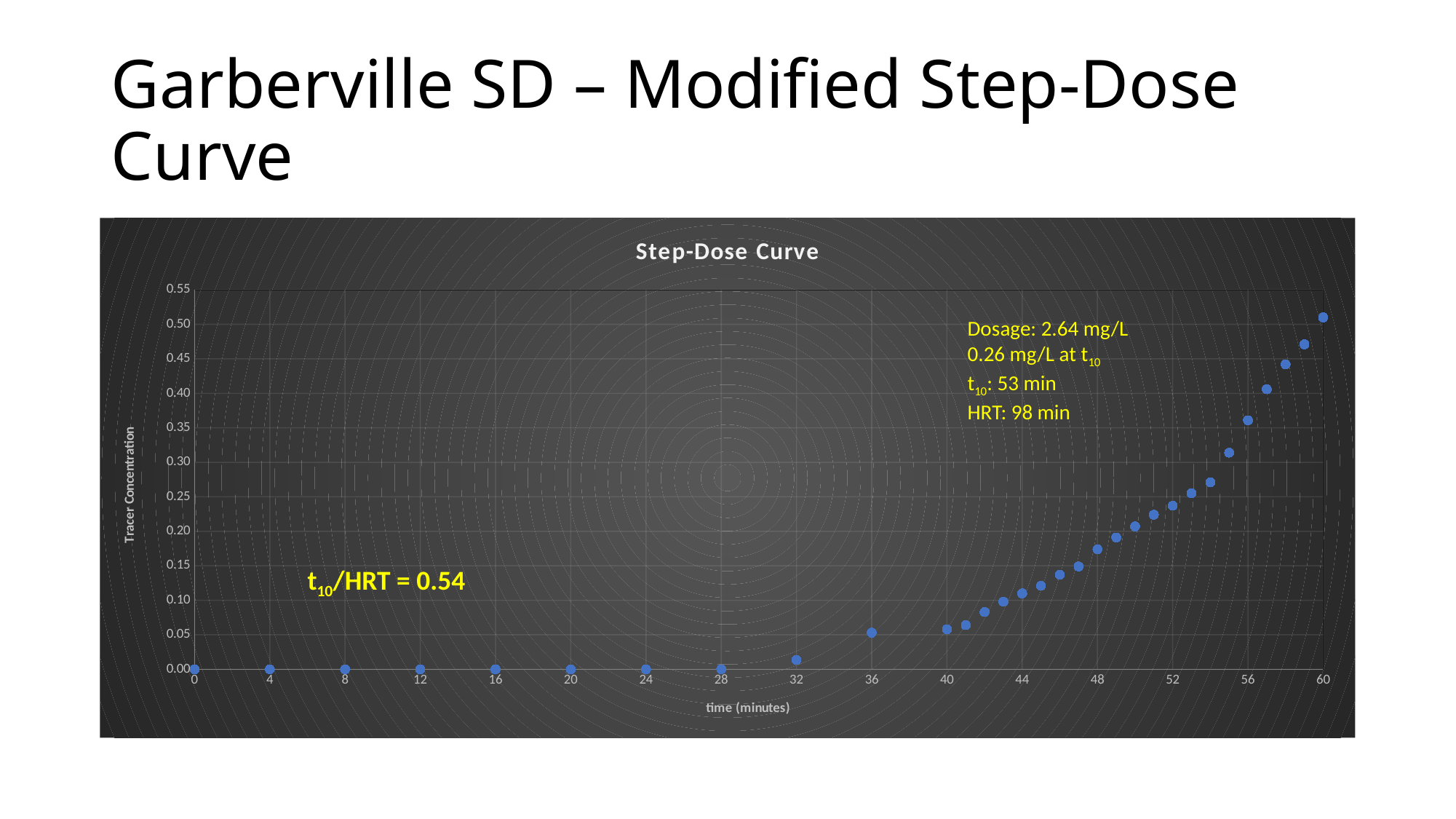
What value of t10/HRT is annotated on the chart? 0.54 What is the tracer concentration at time 0 minutes? 0.00 At which time is the tracer concentration highest? 60 minutes Does the tracer concentration rise or fall as time increases along the x axis? rise What is the title of the chart? Step-Dose Curve Is the tracer concentration at 44 minutes greater or less than 0.15? less Which has the higher tracer concentration, 40 minutes or 60 minutes? 60 minutes Is the tracer concentration at 56 minutes greater or less than 0.30? greater What is the tracer concentration at time 20 minutes? 0.00 What kind of chart is shown on the slide? scatter chart Is the tracer concentration at 48 minutes greater or less than 0.20? less